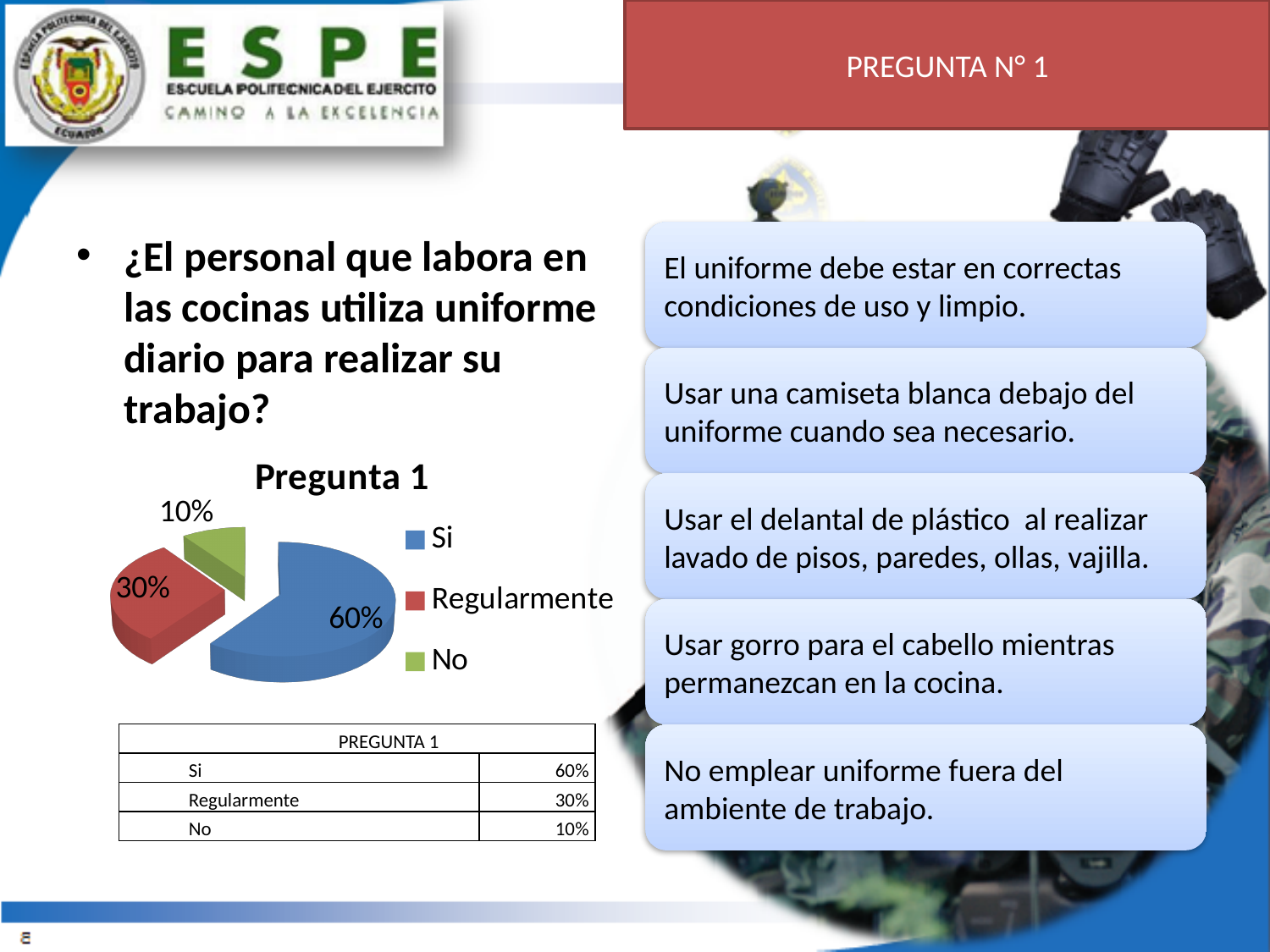
What percentage of the pie is the 'No' slice? 10% What is the title of the chart? Pregunta 1 What is the difference in percentage points between the 'Si' and 'Regularmente' slices? 30% Which slice is larger, 'Regularmente' or 'No'? Regularmente How many slices does the pie chart have? 3 What percentage of the pie is the 'Si' slice? 60% Which category has the smallest share of the pie? No Which category has the largest share of the pie? Si What percentage of the pie is the 'Regularmente' slice? 30% How many entries does the legend list? 3 What colour is the 'Si' slice in the pie chart? Blue What type of chart is shown on the slide? Pie chart